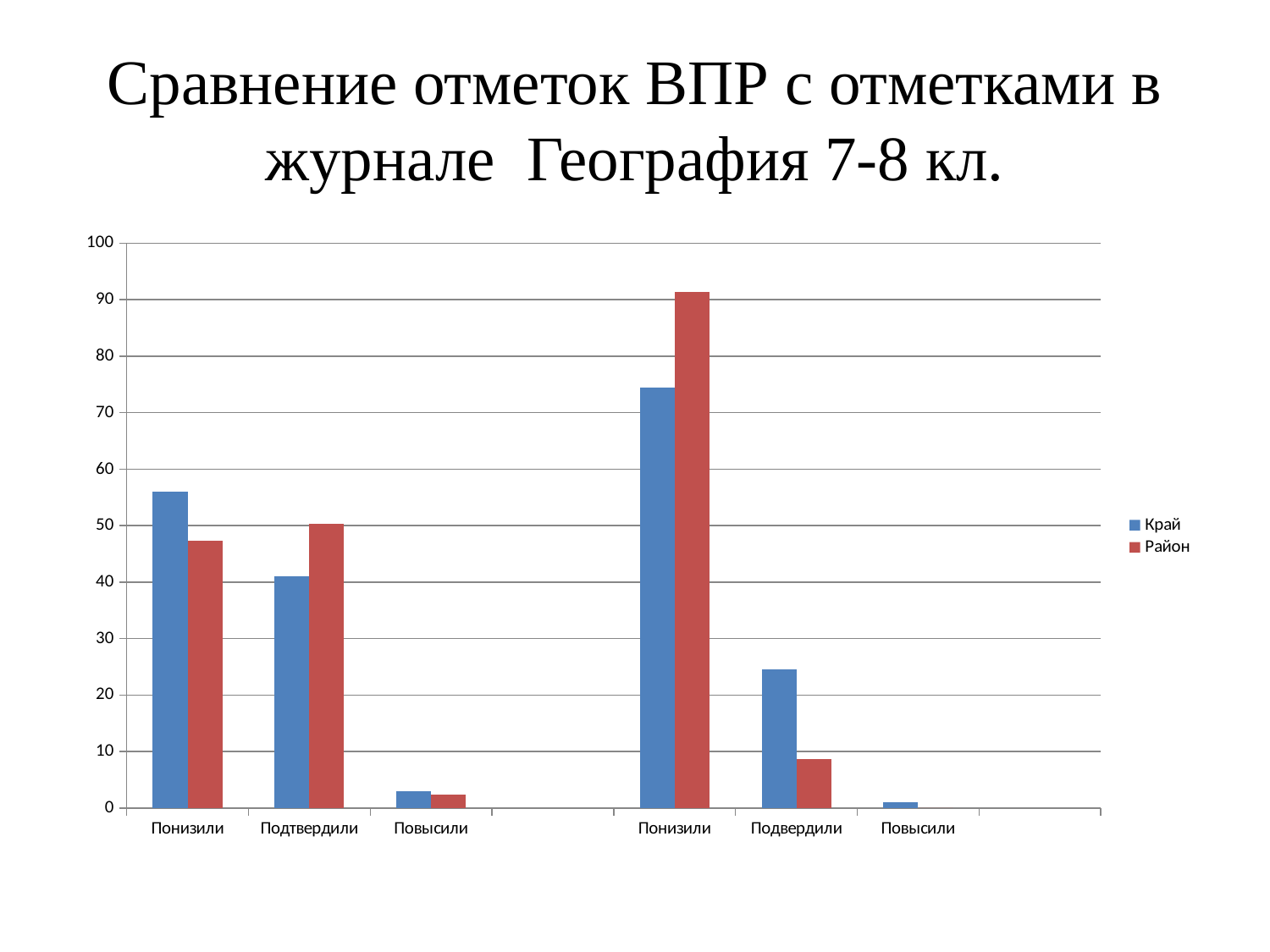
Which bar is the tallest in the whole chart? Район for Понизили in the right-hand group How many series does the legend list? 2 Is the value for Район for Понизили in the right-hand group greater or less than 80? greater For Подвердили in the right-hand group, which series has the larger value, Край or Район? Край How many category labels are shown along the x axis? 6 For Понизили in the left-hand group, which series has the larger value, Край or Район? Край What kind of chart is shown on the slide? bar chart Is the value for Край for Понизили in the right-hand group greater or less than 70? greater Is the value for Район for Подвердили in the right-hand group greater or less than 10? less For Подтвердили in the left-hand group, which series has the larger value, Край or Район? Район What are the two series named in the legend? Край and Район